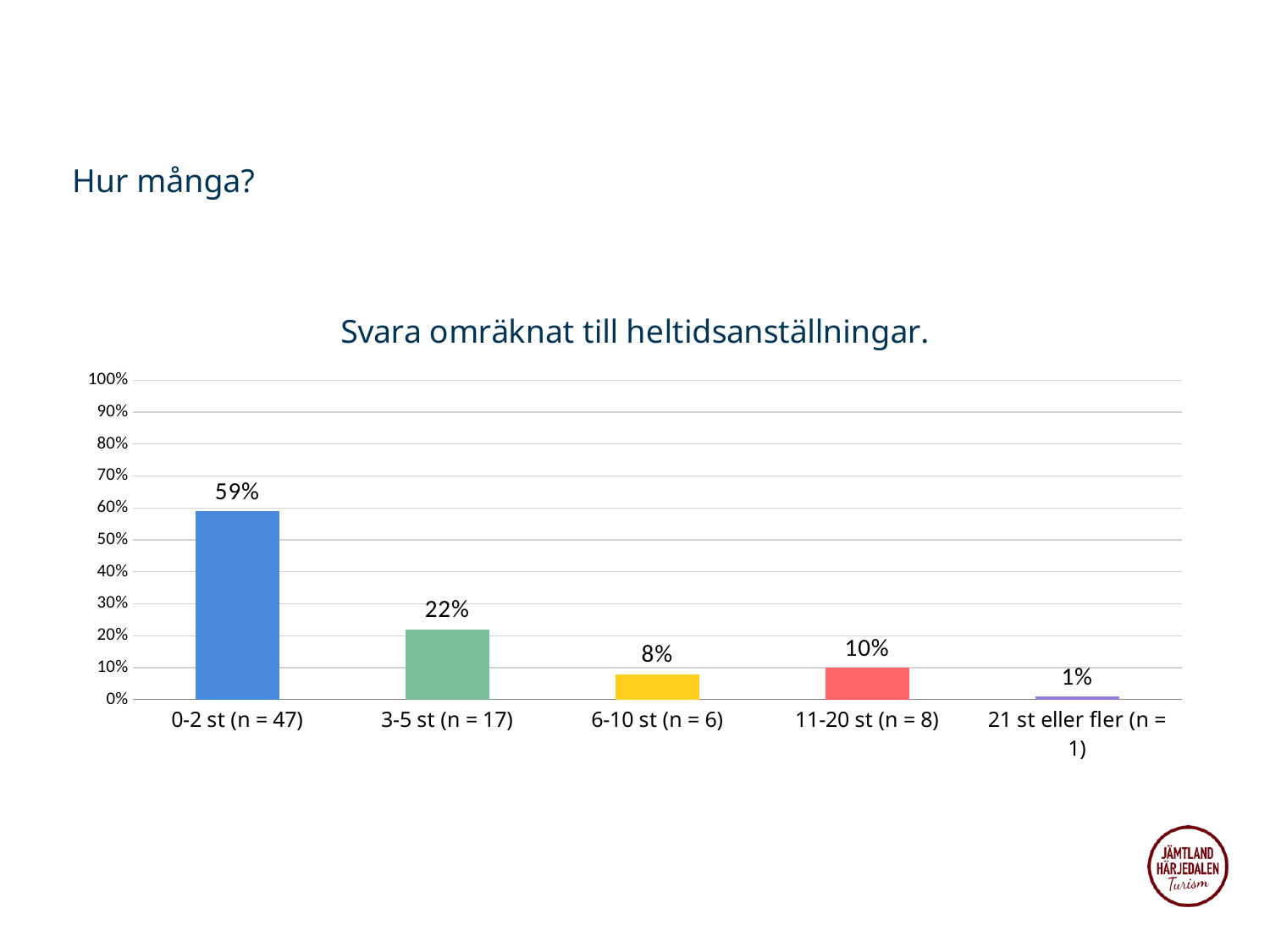
Which is larger, the value for "6-10 st (n = 6)" or the value for "11-20 st (n = 8)"? 11-20 st (n = 8) Which category has the lowest value? 21 st eller fler (n = 1) What is the value for the category "6-10 st (n = 6)"? 8% What is the value for the category "0-2 st (n = 47)"? 59% How many categories are shown on the x axis? 5 Which category has the highest value? 0-2 st (n = 47) What is the title of the chart? Svara omräknat till heltidsanställningar. What is the value for the category "3-5 st (n = 17)"? 22% What kind of chart is shown on the slide? Bar chart What is the difference between the values for "0-2 st (n = 47)" and "3-5 st (n = 17)"? 37% What is the value for the category "11-20 st (n = 8)"? 10% What is the value for the category "21 st eller fler (n = 1)"? 1%